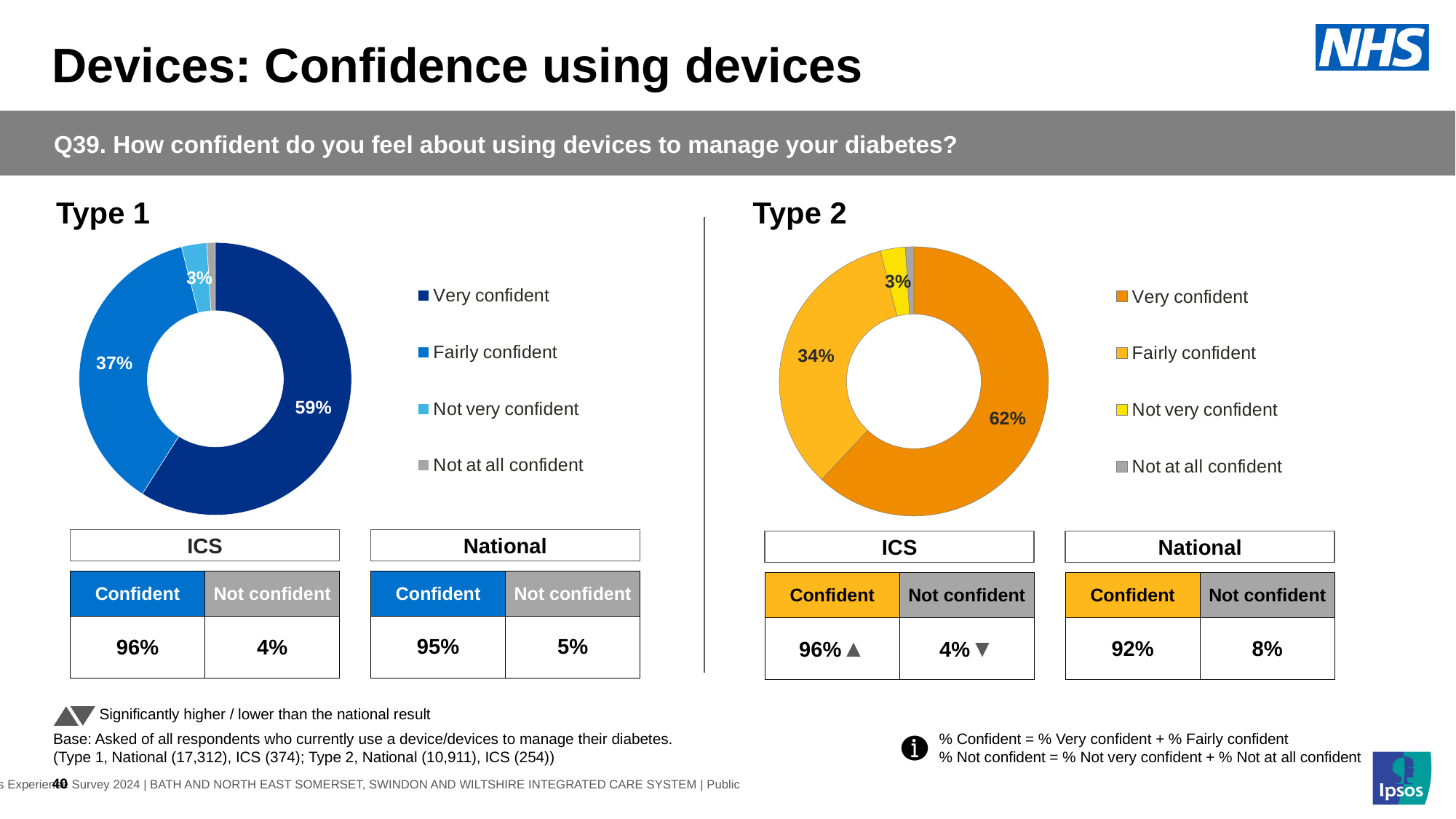
In the Type 1 chart, what percentage of respondents are fairly confident? 37% In the Type 1 chart, what is the difference between the very confident and fairly confident shares? 22% In the Type 2 chart, what percentage of respondents are very confident? 62% In the Type 2 chart, what percentage of respondents are fairly confident? 34% Which is larger: the very confident share in the Type 1 chart or the very confident share in the Type 2 chart? Type 2 What type of chart is used for Type 2? Donut chart In the Type 2 chart, which category has the smallest share? Not at all confident In the Type 1 chart, which category has the largest share? Very confident In the Type 2 chart, what percentage of respondents are not very confident? 3% In the Type 2 chart, what colour represents the 'Not very confident' category? Yellow In the Type 1 chart, what percentage of respondents are very confident? 59% How many categories does the legend of the Type 1 chart list? 4